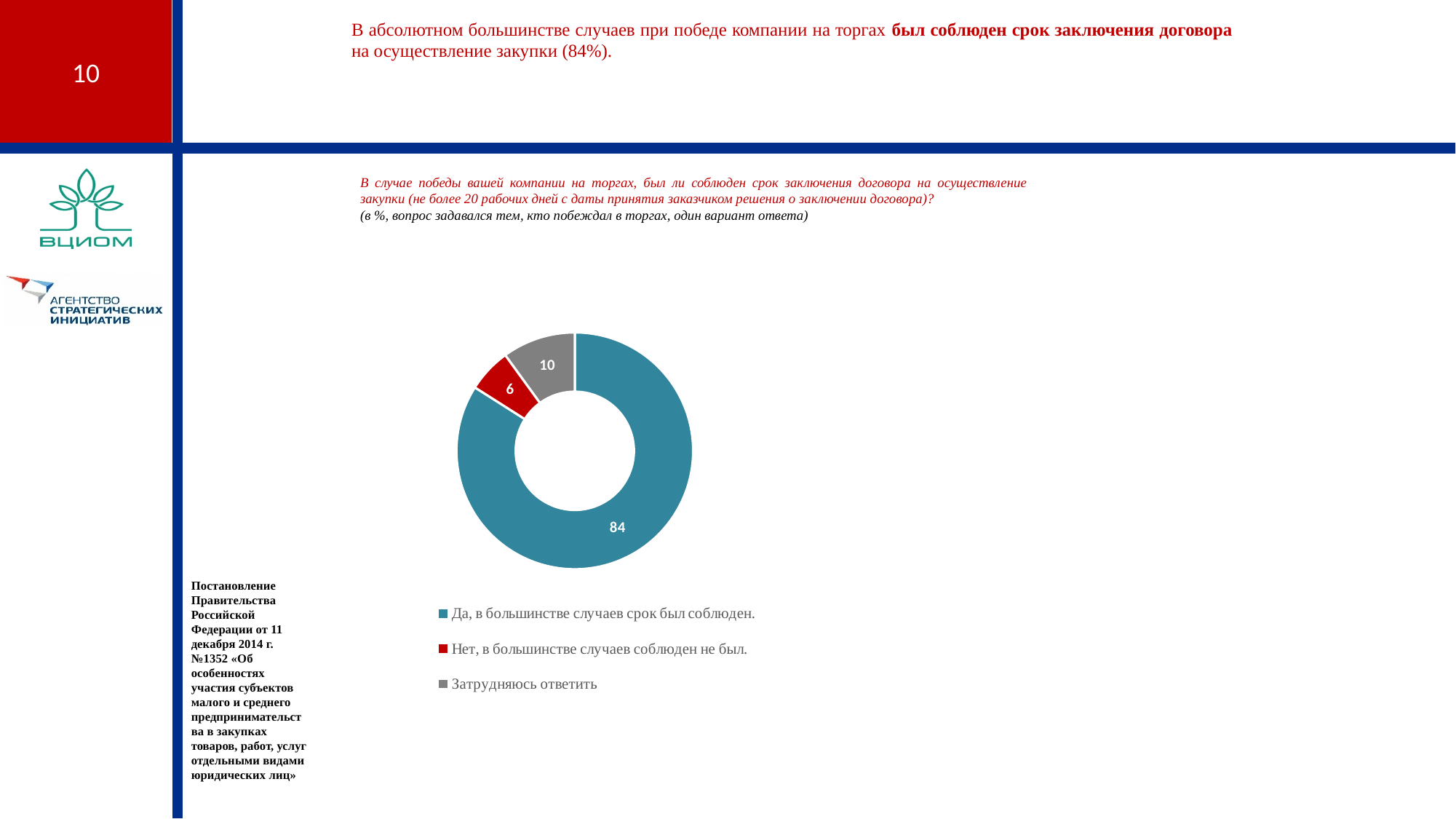
What colour is the slice for 'Нет, в большинстве случаев соблюден не был.'? Red What kind of chart is shown on the slide? Doughnut (pie) chart How many categories does the chart show? 3 What is the difference between the values for 'Да, в большинстве случаев срок был соблюден.' and 'Затрудняюсь ответить'? 74 Which category has the smallest slice of the chart? Нет, в большинстве случаев соблюден не был. What value is shown for the slice 'Затрудняюсь ответить'? 10 Which is larger: the value for 'Затрудняюсь ответить' or the value for 'Нет, в большинстве случаев соблюден не был.'? Затрудняюсь ответить What is the difference between the values for 'Затрудняюсь ответить' and 'Нет, в большинстве случаев соблюден не был.'? 4 What value is shown for the slice 'Да, в большинстве случаев срок был соблюден.'? 84 What value is shown for the slice 'Нет, в большинстве случаев соблюден не был.'? 6 What is the total of the three values shown on the chart? 100 Which category has the largest slice of the chart? Да, в большинстве случаев срок был соблюден.